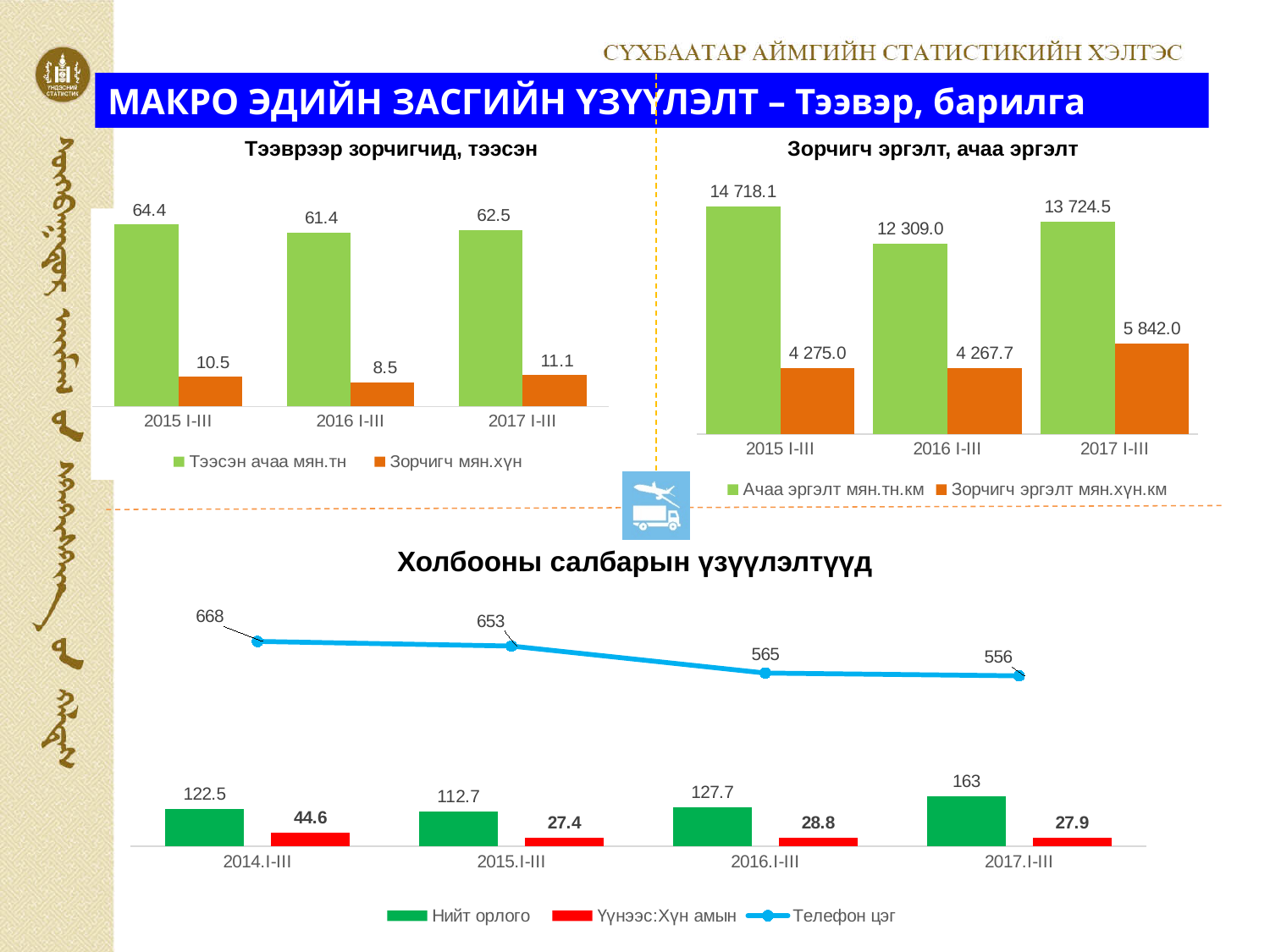
In the chart 'Холбооны салбарын үзүүлэлтүүд', what is the value of Үүнээс:Хүн амын for 2014.I-III? 44.6 In the chart 'Холбооны салбарын үзүүлэлтүүд', does the Телефон цэг line rise or fall from 2014.I-III to 2017.I-III? fall In the chart 'Тээврээр зорчигчид, тээсэн', how many series does the legend list? 2 In the chart 'Зорчигч эргэлт, ачаа эргэлт', which period has the highest value for Ачаа эргэлт мян.тн.км? 2015 I-III In the chart 'Тээврээр зорчигчид, тээсэн', what is the difference between the Тээсэн ачаа мян.тн values for 2015 I-III and 2016 I-III? 3.0 In the chart 'Тээврээр зорчигчид, тээсэн', what is the value of Тээсэн ачаа мян.тн for 2015 I-III? 64.4 In the chart 'Зорчигч эргэлт, ачаа эргэлт', what is the value of Ачаа эргэлт мян.тн.км for 2016 I-III? 12 309.0 In the chart 'Тээврээр зорчигчид, тээсэн', which period has the lowest value for Зорчигч мян.хүн? 2016 I-III In the chart 'Холбооны салбарын үзүүлэлтүүд', which period has the highest value for Нийт орлого? 2017.I-III In the chart 'Зорчигч эргэлт, ачаа эргэлт', is the Зорчигч эргэлт мян.хүн.км value for 2017 I-III larger or smaller than the value for 2016 I-III? larger In the chart 'Зорчигч эргэлт, ачаа эргэлт', how many periods are shown on the x axis? 3 In the chart 'Холбооны салбарын үзүүлэлтүүд', what is the value of Телефон цэг for 2016.I-III? 565